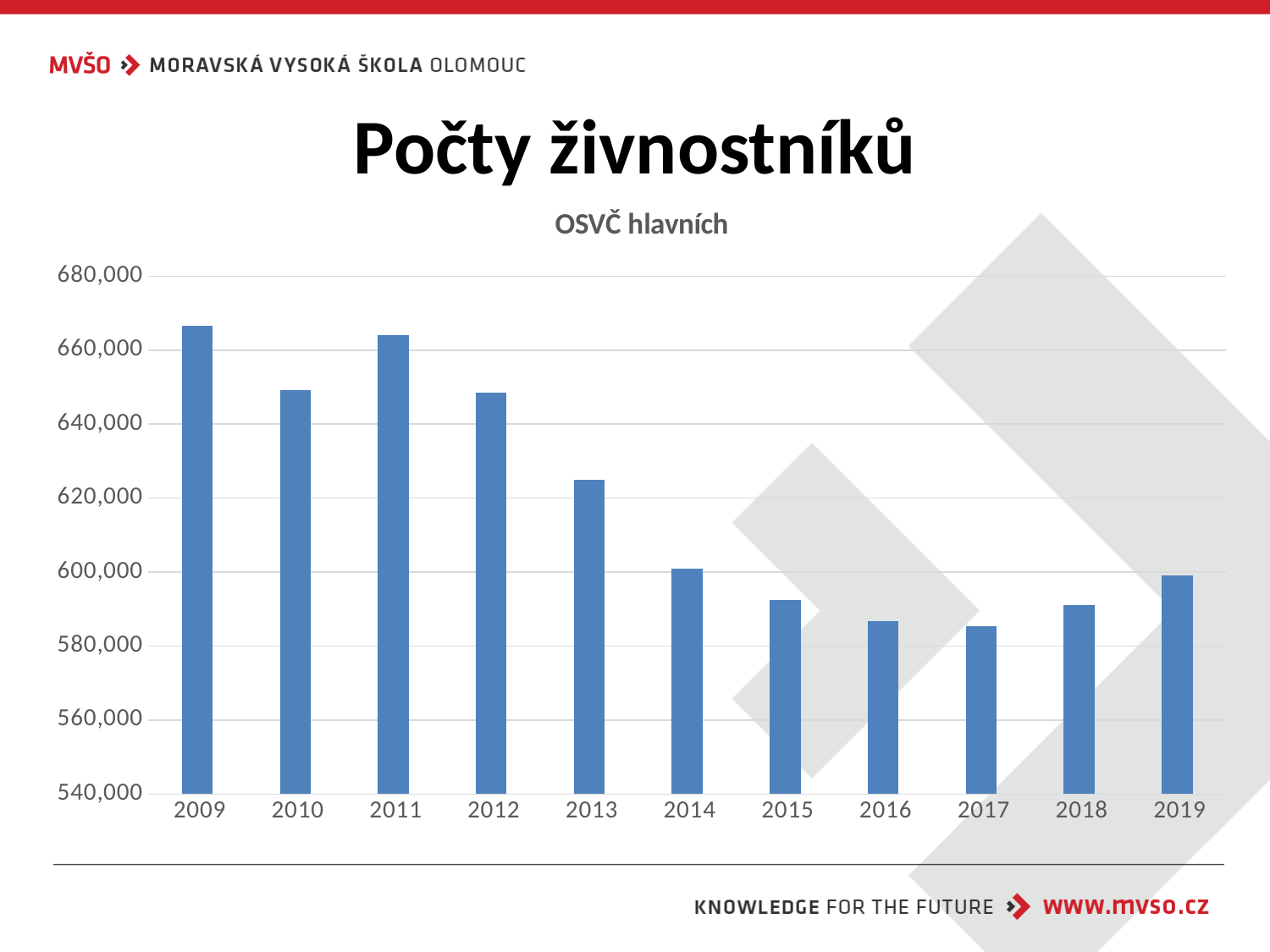
Which year has the larger value, 2016 or 2019? 2019 Is the value for 2013 greater or less than 620,000? greater Is the value for 2015 greater or less than 600,000? less Do the values generally rise or fall from 2009 to 2017? fall Is the value for 2010 greater or less than 640,000? greater What is the title of the chart? OSVČ hlavních Which year has the larger value, 2009 or 2010? 2009 What kind of chart is shown on the slide? bar chart How many years are shown on the x axis of the chart? 11 Which year has the larger value, 2013 or 2018? 2013